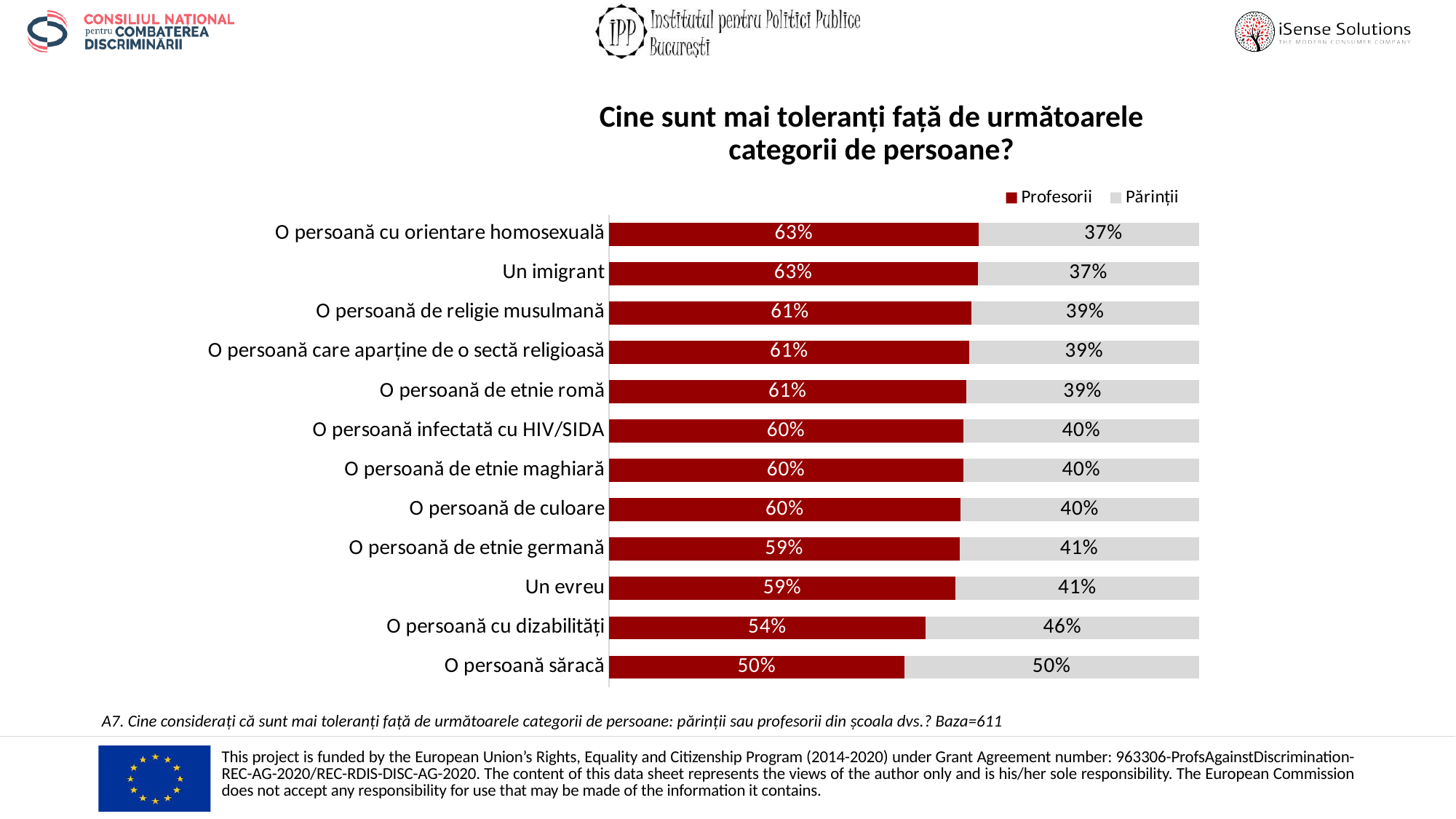
Which is larger for "O persoană cu dizabilități": the Profesorii value or the Părinții value? Profesorii How many categories of persons are shown in the chart? 12 What is the Profesorii value for "Un imigrant"? 63% What is the difference between the Profesorii and Părinții values for "O persoană de etnie romă"? 22% Which category has the lowest Profesorii value? O persoană săracă Which category has the highest Părinții value? O persoană săracă What is the total of the stacked bar for "O persoană infectată cu HIV/SIDA"? 100% What is the Părinții value for "O persoană de etnie germană"? 41% How many series does the legend list? 2 What percentage of respondents said teachers (Profesorii) are more tolerant toward "O persoană cu dizabilități"? 54% Which colour represents the Profesorii series in the chart? Dark red What kind of chart is shown on the slide? Stacked bar chart